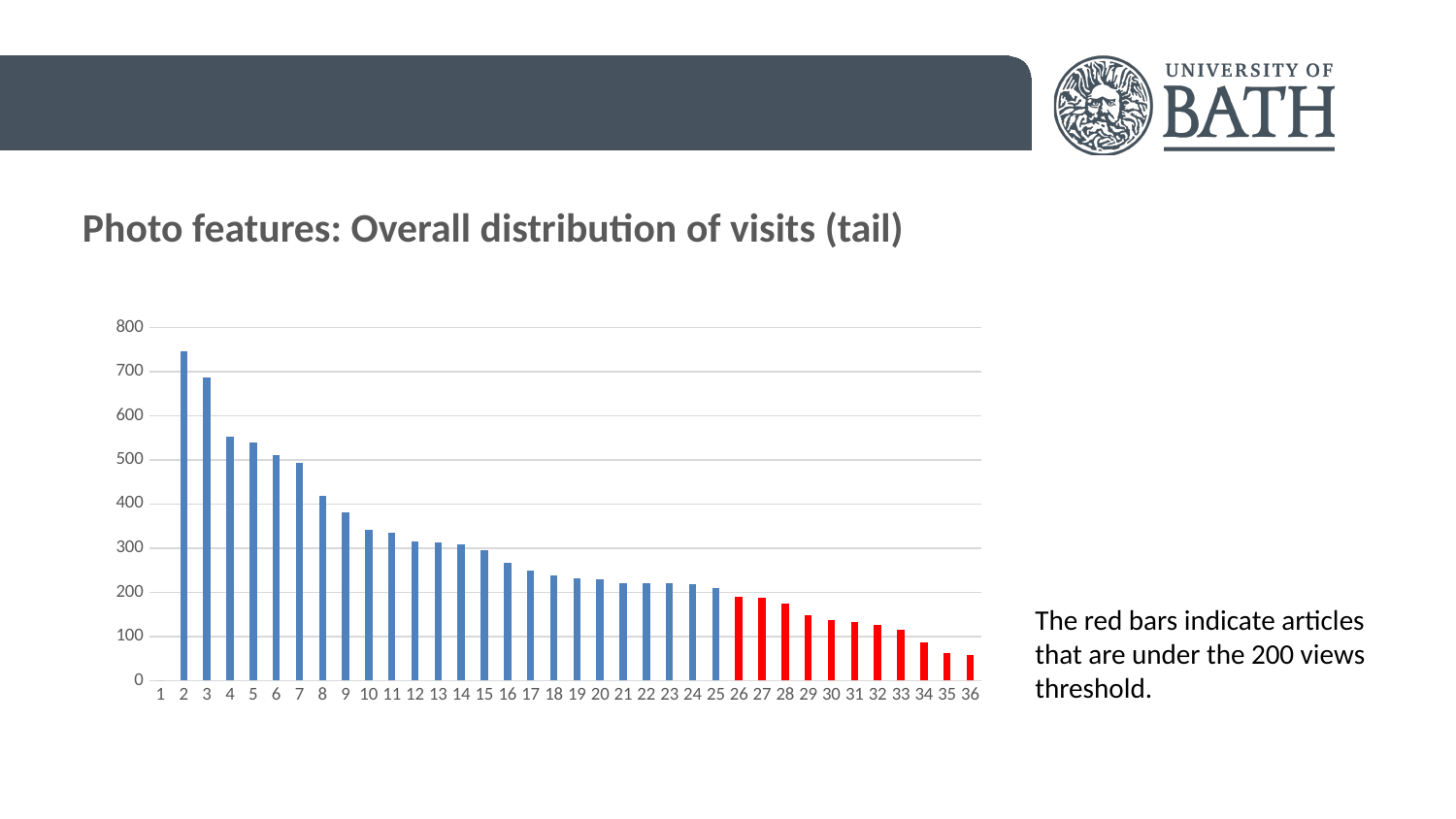
Is the value for category 8 greater or less than 400? greater What is the title of the chart on the slide? Photo features: Overall distribution of visits (tail) Is the value for category 30 greater or less than 100? greater How many categories are labelled along the x axis of the chart? 36 Is the value for category 16 greater or less than 300? less How many bars in the chart are coloured red? 11 What kind of chart is shown on the slide? bar chart Which category has the tallest bar in the chart? 2 Which has the larger value, category 2 or category 3? category 2 Do the bar values generally rise or fall from left to right along the x axis? fall